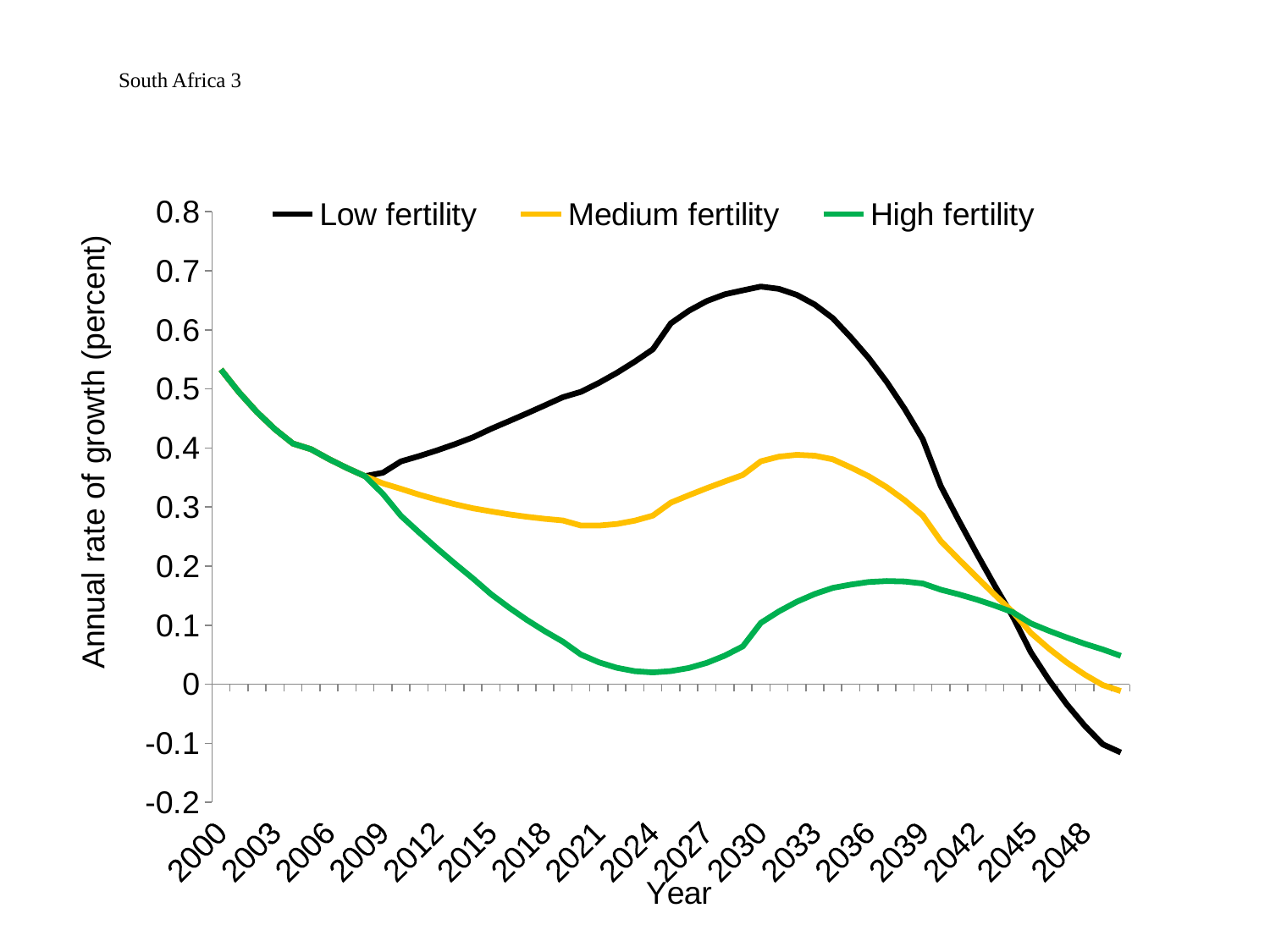
Is the value for Medium fertility in 2033 greater or less than 0.3? greater In 2030, which series has the higher value, Low fertility or Medium fertility? Low fertility How many series does the legend list? 3 What is the title of the vertical axis? Annual rate of growth (percent) Is the value for Low fertility in 2030 greater or less than 0.6? greater Is the value for High fertility in 2024 greater or less than 0.1? less What kind of chart is shown on the slide? line chart What are the three series named in the legend? Low fertility, Medium fertility, High fertility In 2048, which series has the higher value, High fertility or Low fertility? High fertility Which series reaches the highest value anywhere on the chart? Low fertility Does the Low fertility line rise or fall between 2030 and 2048? fall Which series has the lowest value at the right-hand end of the chart? Low fertility